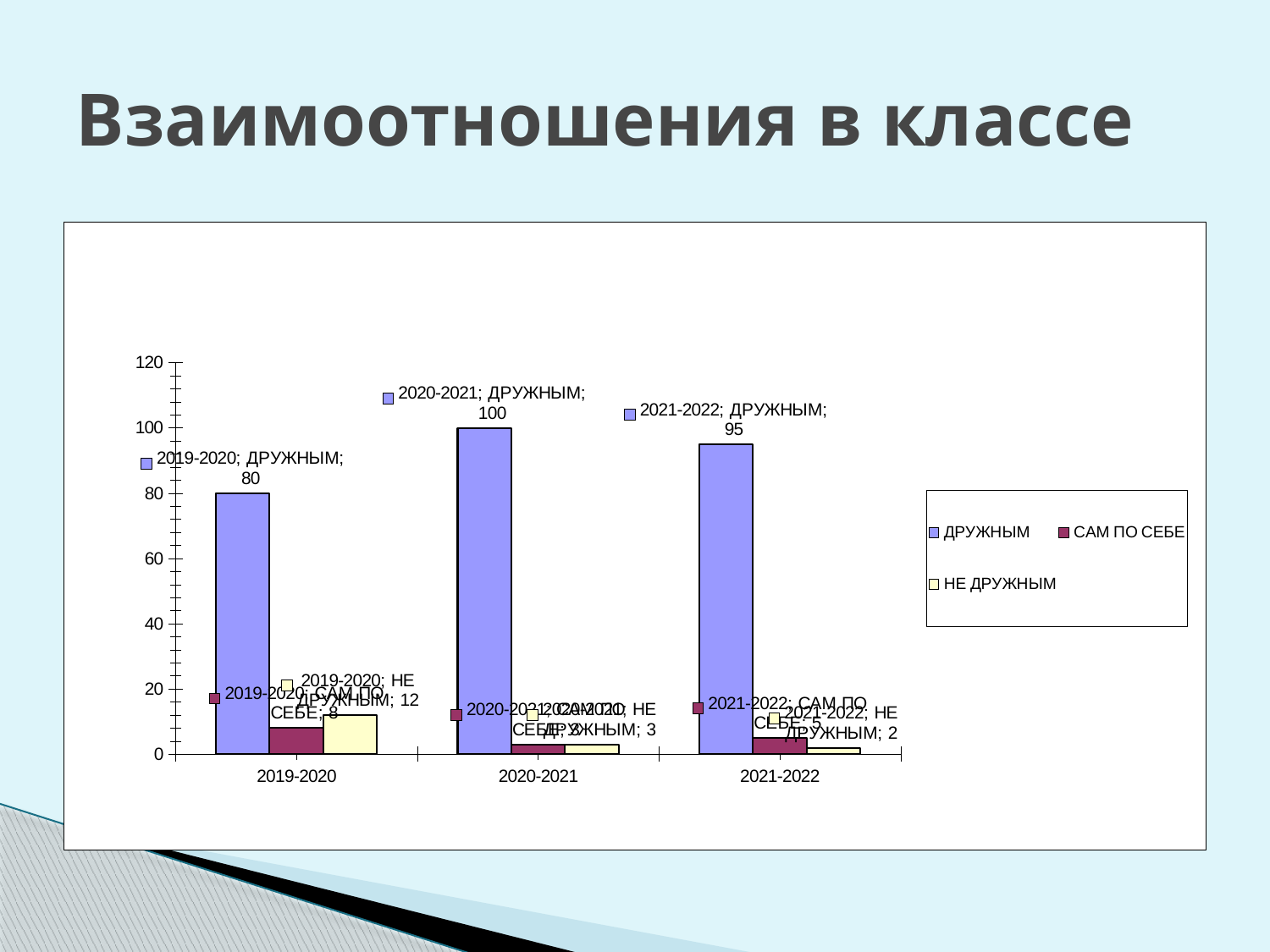
What is the difference between the ДРУЖНЫМ values for 2020-2021 and 2019-2020? 20 Which is larger: the ДРУЖНЫМ value for 2021-2022 or for 2019-2020? 2021-2022 How many school years are shown on the x axis? 3 What is the value for ДРУЖНЫМ in 2021-2022? 95 What is the value for НЕ ДРУЖНЫМ in 2019-2020? 12 How many series does the legend list? 3 What is the value for НЕ ДРУЖНЫМ in 2021-2022? 2 What is the value for ДРУЖНЫМ in 2019-2020? 80 In which school year is the ДРУЖНЫМ value highest? 2020-2021 What is the value for ДРУЖНЫМ in 2020-2021? 100 In which school year is the НЕ ДРУЖНЫМ value lowest? 2021-2022 What type of chart is shown on the slide? bar chart